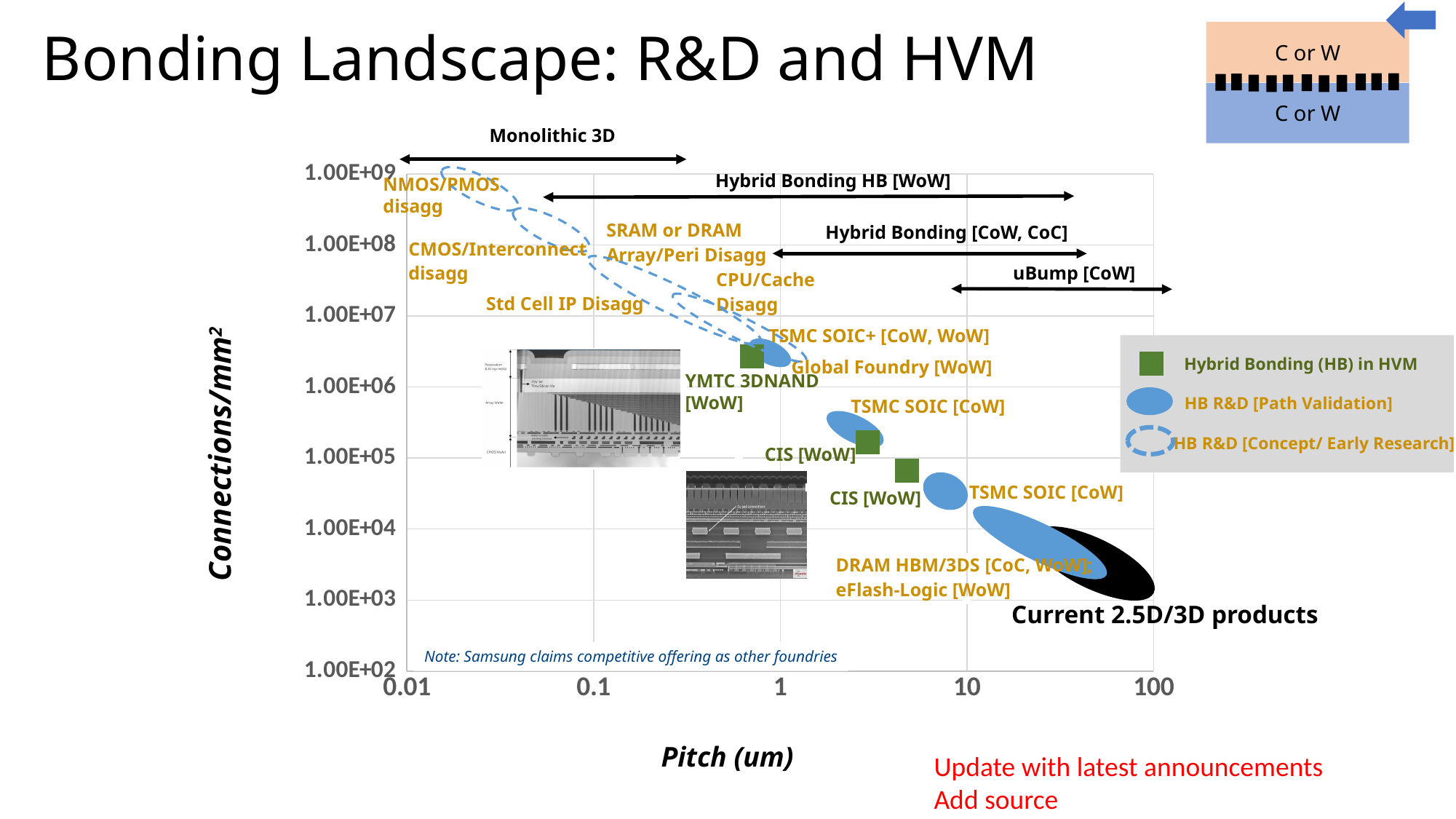
Is the pitch for the Current 2.5D/3D products bubble greater or less than 10 um? greater Among the green square (HB in HVM) points, which has the highest Connections/mm²? YMTC 3DNAND [WoW] How many entries does the chart legend list? 3 Is the Connections/mm² value for the Current 2.5D/3D products bubble greater or less than 1.00E+04? less What kind of chart is shown on the slide? scatter chart What is the label of the x axis? Pitch (um) Is the Connections/mm² value for YMTC 3DNAND [WoW] greater or less than 1.00E+06? greater Which has a higher Connections/mm² value, YMTC 3DNAND [WoW] or CIS [WoW]? YMTC 3DNAND [WoW] As pitch increases along the x axis, do the Connections/mm² values rise or fall? fall How many green square markers (Hybrid Bonding in HVM) are plotted on the chart? 3 What is the label of the y axis? Connections/mm²